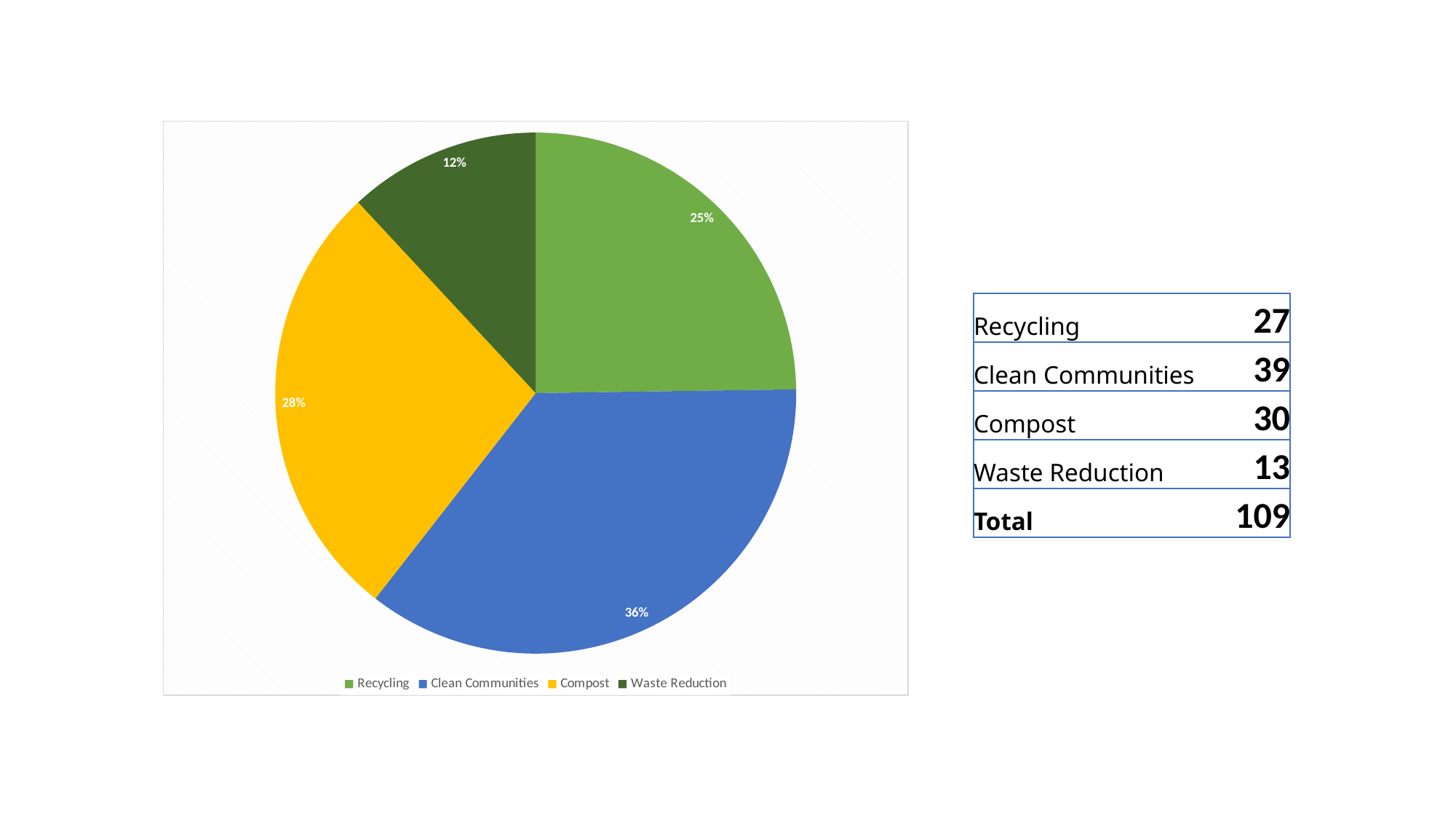
Which slice is larger, Compost or Recycling? Compost What percentage of the pie does Recycling represent? 25% Which category has the smallest slice of the pie? Waste Reduction What percentage of the pie does Compost represent? 28% What kind of chart is shown on the slide? pie chart How many categories does the pie chart show? 4 What percentage of the pie does Waste Reduction represent? 12% What is the difference in percentage points between the Clean Communities slice and the Waste Reduction slice? 24 Which category has the largest slice of the pie? Clean Communities What colour is the Compost slice? yellow Which category is shown in blue in the legend? Clean Communities